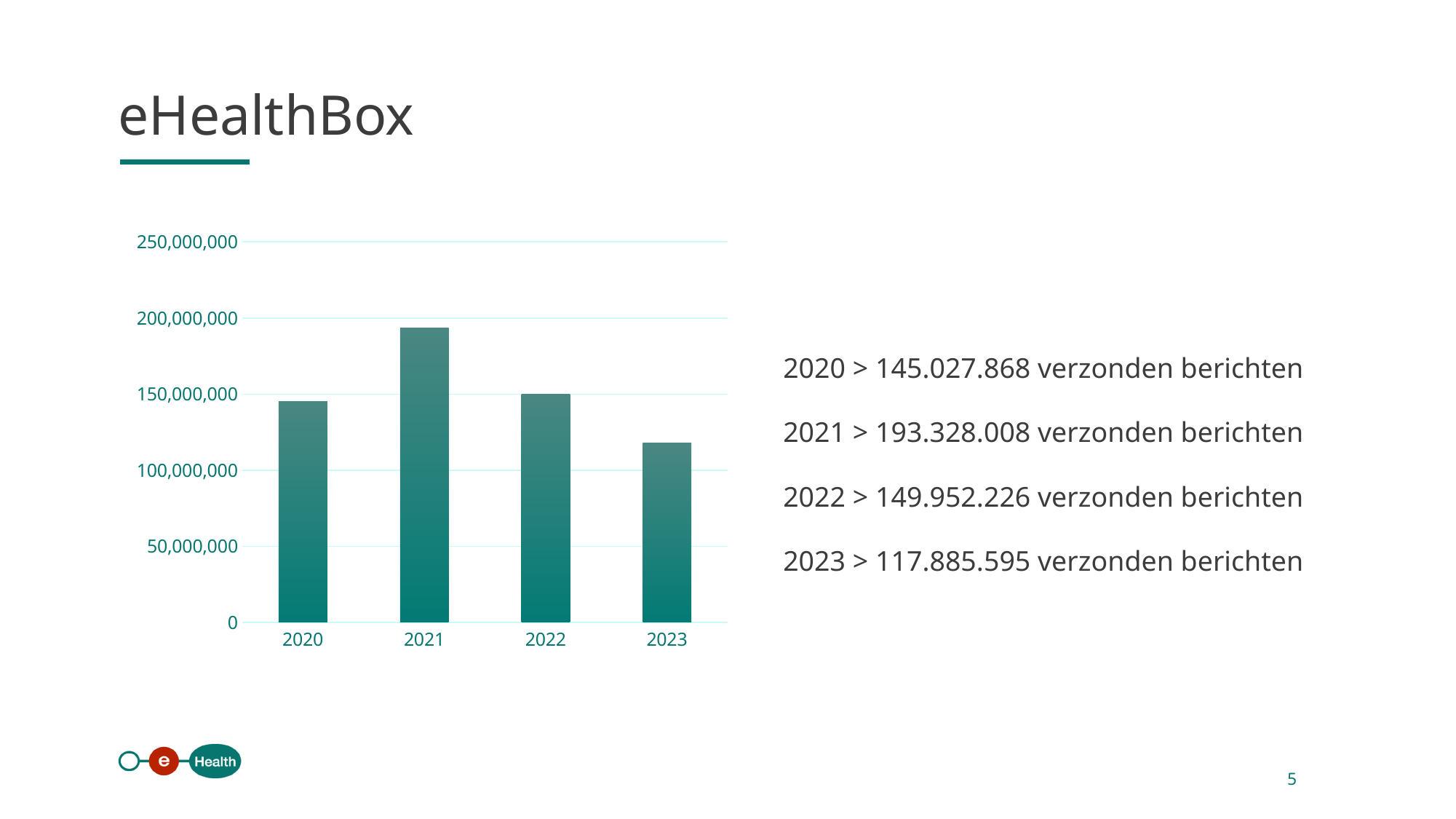
How many verzonden berichten are listed for 2020? 145.027.868 How many verzonden berichten are listed for 2021? 193.328.008 What is the difference between the number of verzonden berichten in 2021 and in 2020? 48.300.140 What is the title of the slide containing the chart? eHealthBox How many verzonden berichten are listed for 2023? 117.885.595 Which year has the highest bar in the chart? 2021 What type of chart is shown on the slide? bar chart Is the value for 2023 greater or less than 150,000,000? less Which is larger, the value for 2020 or the value for 2021? 2021 How many years are shown on the x axis of the chart? 4 Which year has the lowest bar in the chart? 2023 Is the value for 2021 greater or less than 150,000,000? greater